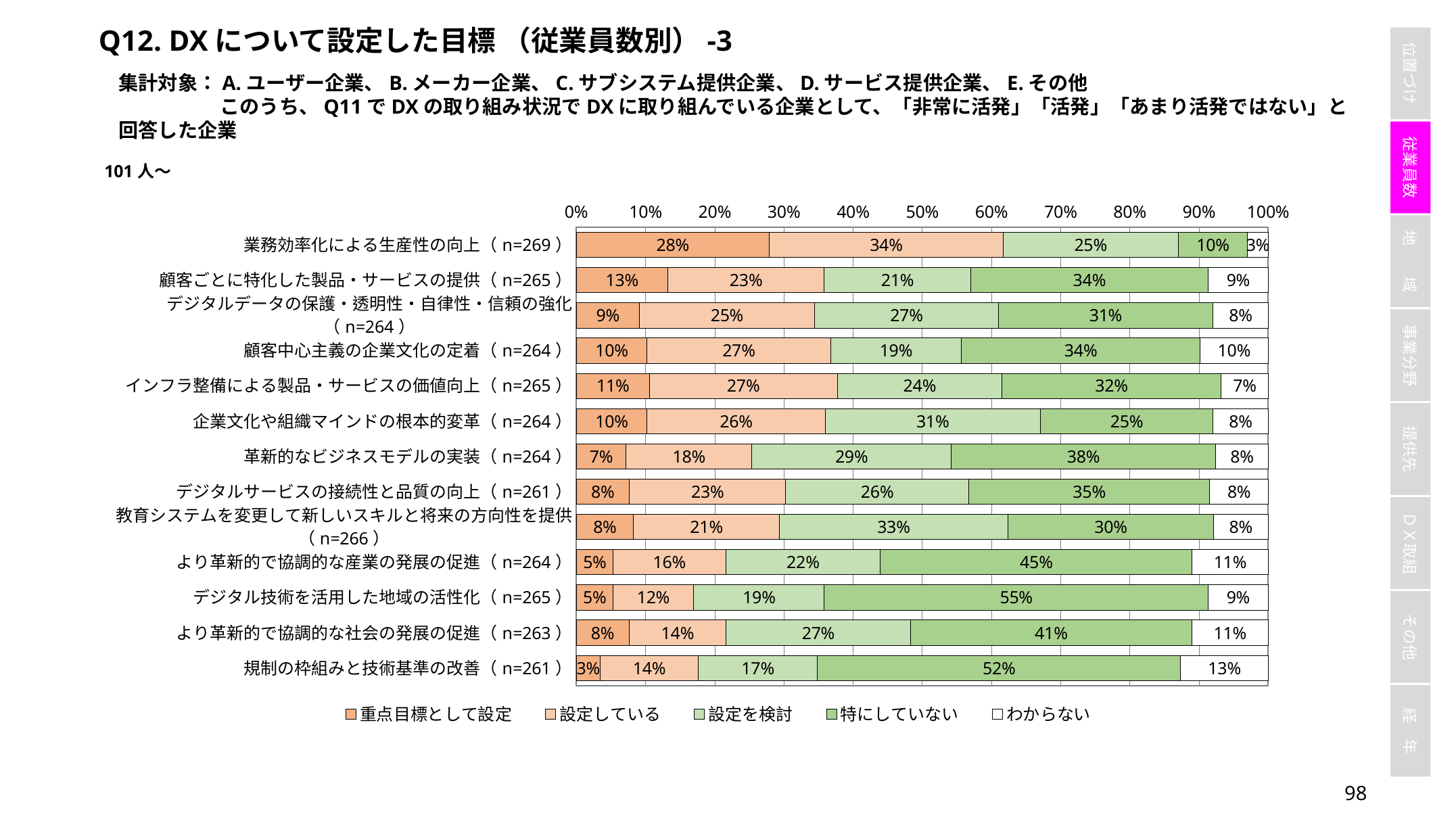
What is the わからない value for 規制の枠組みと技術基準の改善 (n=261)? 13% Which is larger: the 設定を検討 value for 教育システムを変更して新しいスキルと将来の方向性を提供 (n=266) or for 顧客中心主義の企業文化の定着 (n=264)? 教育システムを変更して新しいスキルと将来の方向性を提供 (n=266) What is the 特にしていない value for デジタル技術を活用した地域の活性化 (n=265)? 55% Which category has the highest 特にしていない value? デジタル技術を活用した地域の活性化 (n=265) What is the difference between the 設定している values for 業務効率化による生産性の向上 (n=269) and 革新的なビジネスモデルの実装 (n=264)? 16% What is the 重点目標として設定 value for 業務効率化による生産性の向上 (n=269)? 28% What is the total of the stacked bar for 顧客ごとに特化した製品・サービスの提供 (n=265)? 100% How many series does the legend list? 5 How many categories (goals) are plotted in the chart? 13 Which category has the highest 重点目標として設定 value? 業務効率化による生産性の向上 (n=269) Which category has the lowest 重点目標として設定 value? 規制の枠組みと技術基準の改善 (n=261) What type of chart is shown on the slide? Stacked bar chart